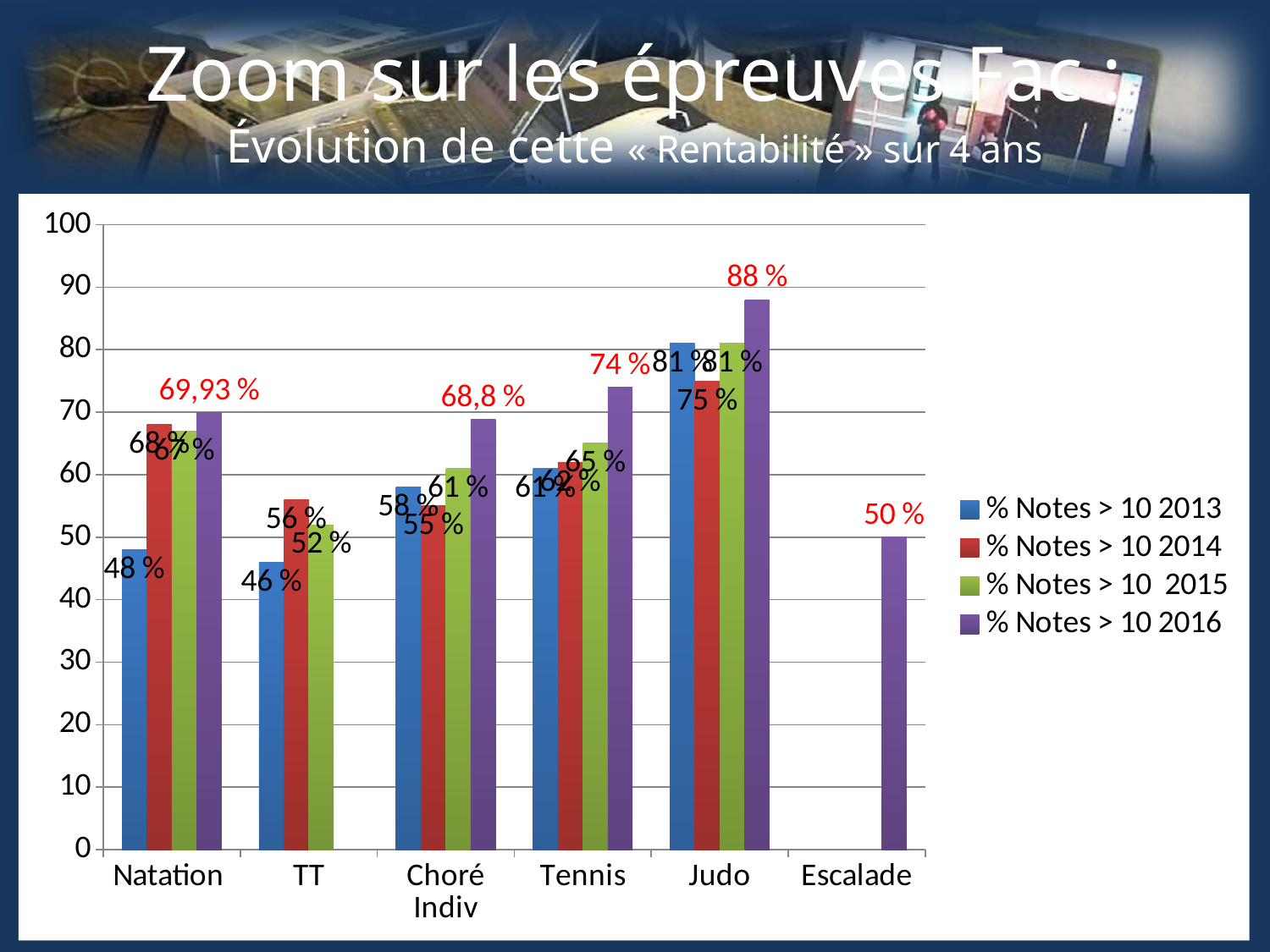
Which category has the highest value in the series % Notes > 10 2016? Judo What is the value for Escalade in the series % Notes > 10 2016? 50 % How many categories are shown on the x axis of the chart? 6 What is the value for Judo in the series % Notes > 10 2016? 88 % How many series does the legend list? 4 What kind of chart is shown on the slide? bar chart What is the value for Choré Indiv in the series % Notes > 10 2016? 68,8 % What colour are the bars for the series % Notes > 10 2016? purple Which category has the lowest value in the series % Notes > 10 2013? TT For TT, which is larger: the value for % Notes > 10 2014 or % Notes > 10 2015? % Notes > 10 2014 What is the difference between the Judo values for % Notes > 10 2016 and % Notes > 10 2014? 13 % What is the value for Natation in the series % Notes > 10 2013? 48 %